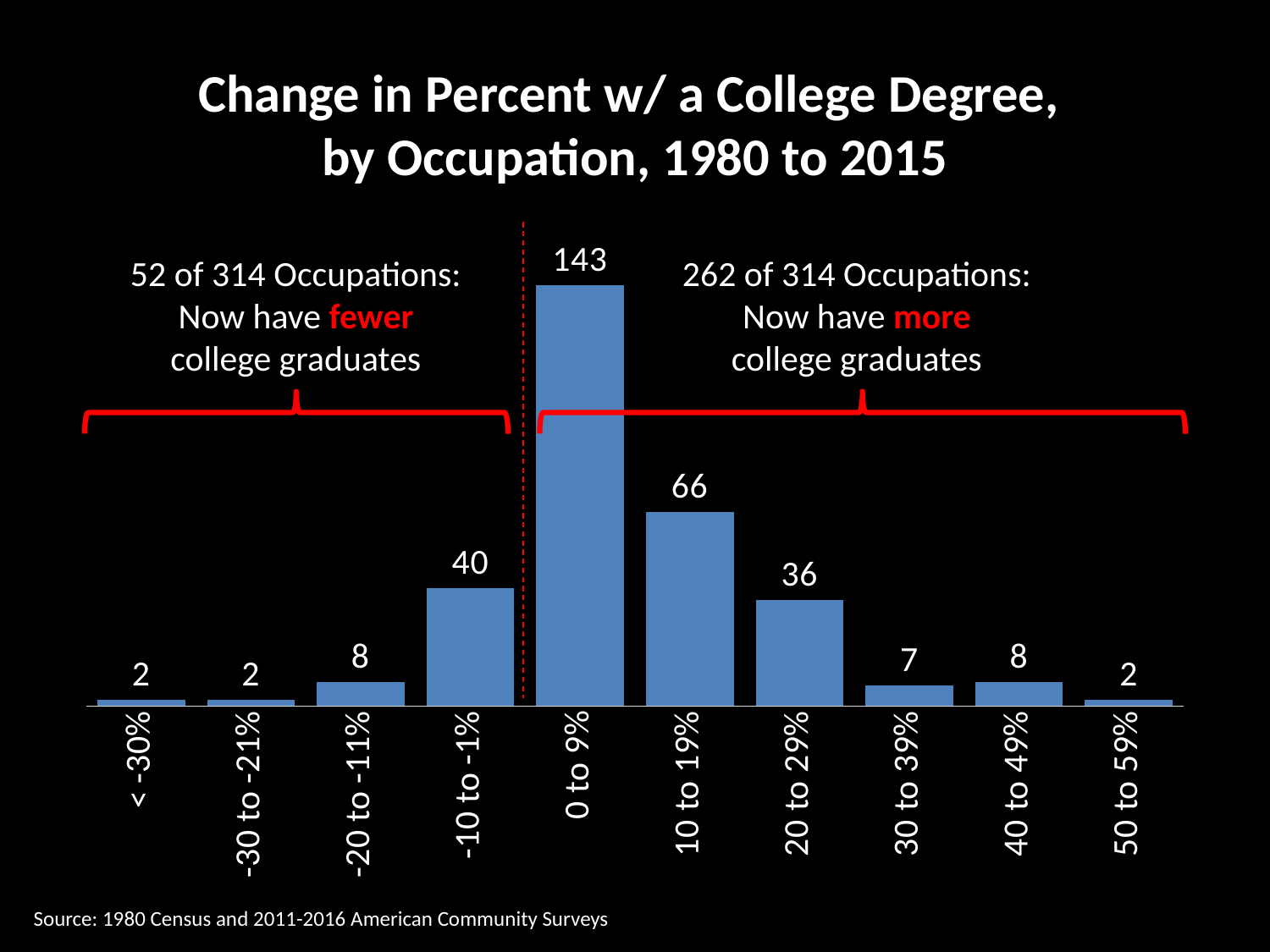
What is the value for the -10 to -1% category? 40 Which is larger, the value for 10 to 19% or the value for 20 to 29%? 10 to 19% Which is larger, the value for -20 to -11% or the value for 30 to 39%? -20 to -11% What is the value for the 0 to 9% category? 143 What is the difference between the values for -10 to -1% and -20 to -11%? 32 Which category has the highest value? 0 to 9% How many categories are shown on the x axis? 10 What is the value for the 20 to 29% category? 36 What is the value for the 30 to 39% category? 7 What kind of chart is shown on the slide? Bar chart What is the difference between the values for 0 to 9% and 10 to 19%? 77 What is the title of the chart? Change in Percent w/ a College Degree, by Occupation, 1980 to 2015